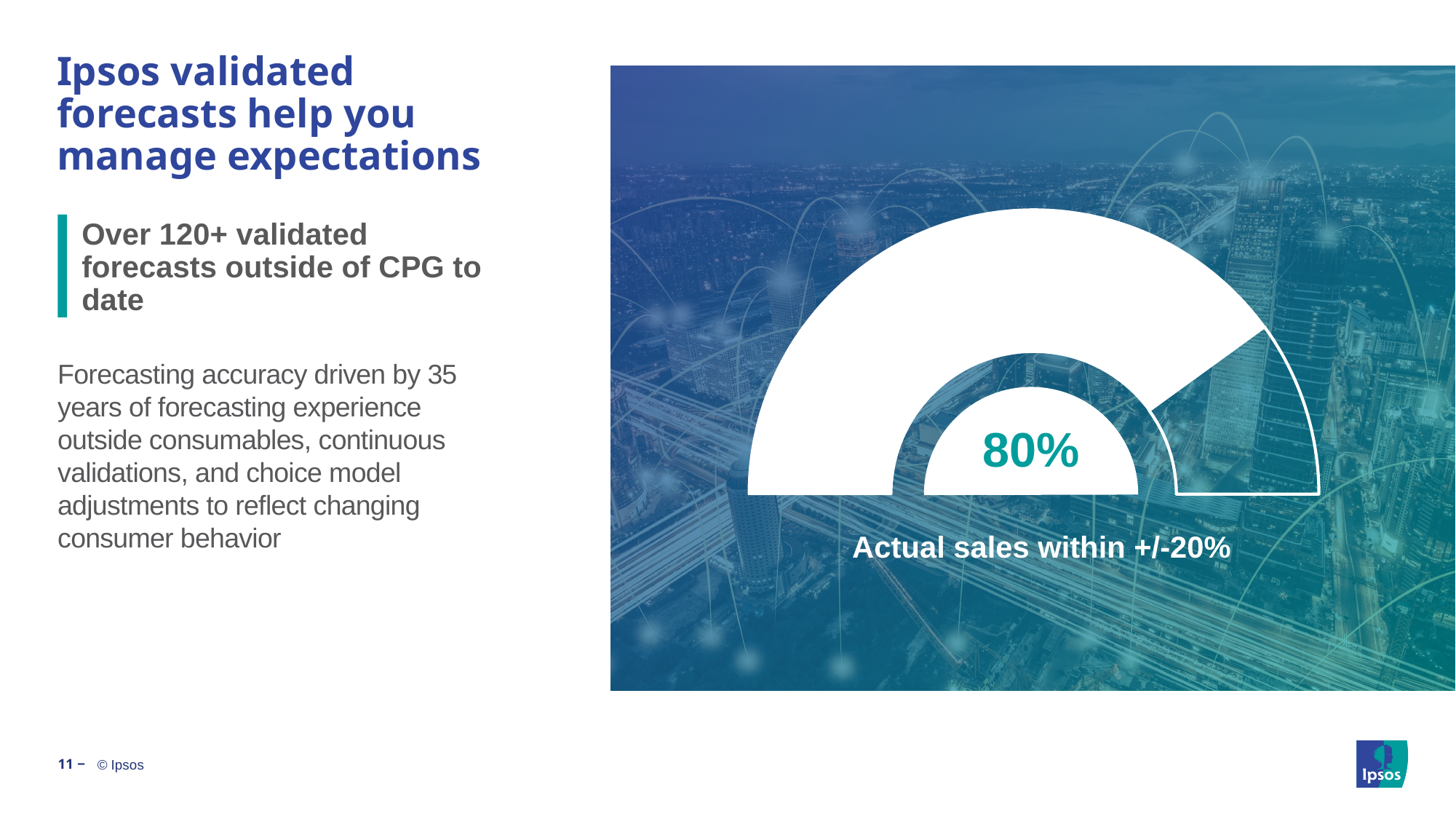
What does the 80% in the gauge chart represent, according to the label beneath it? Actual sales within +/-20% How many data values are shown on the gauge chart? 1 What colour is the filled portion of the gauge chart? White What share of the gauge arc is filled in white? 80% Is the value shown on the gauge chart greater or less than 50%? greater What kind of chart is shown on the right side of the slide? Gauge chart What percentage value is displayed in the centre of the gauge chart? 80%